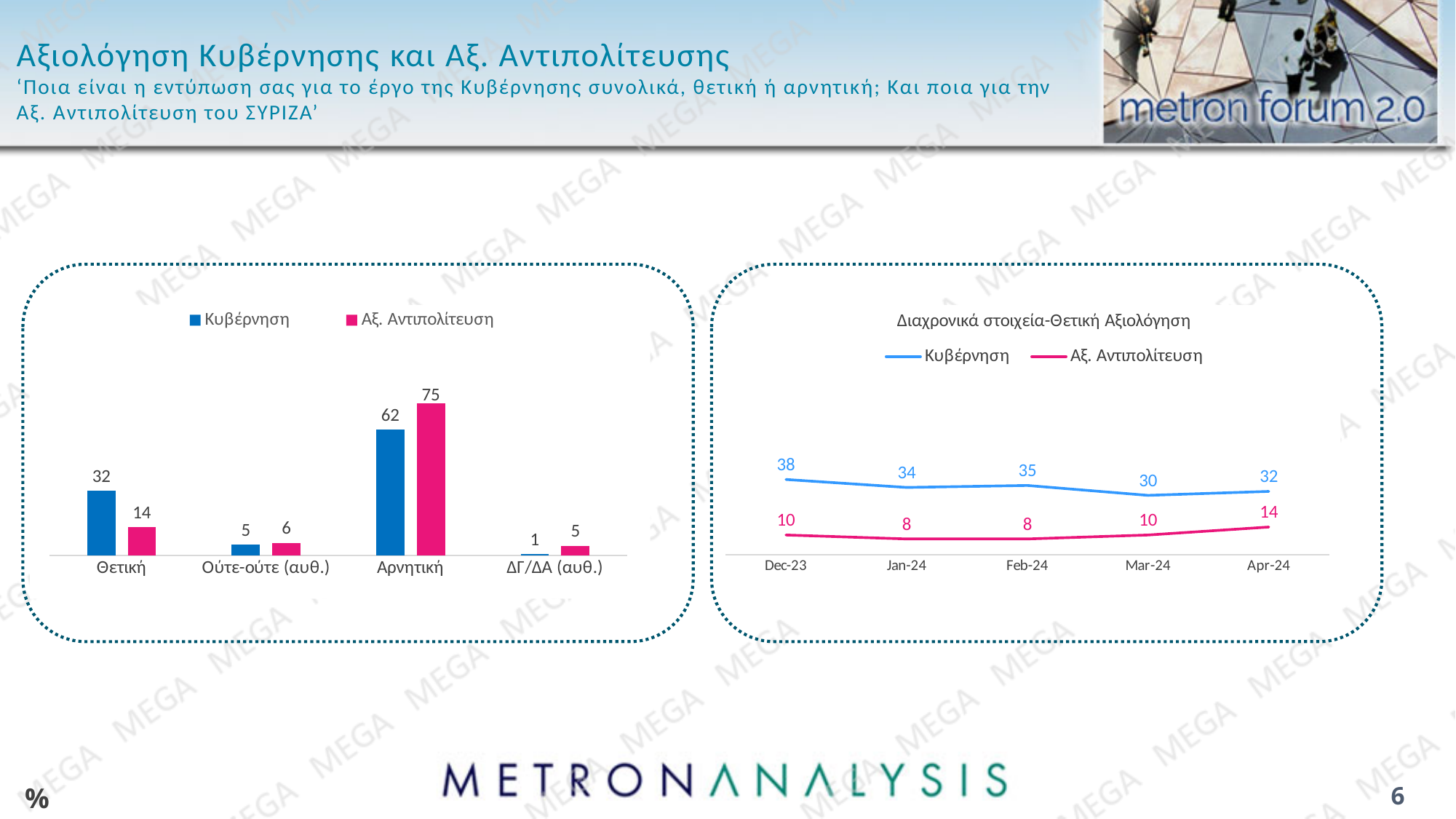
What type of chart is the chart on the right, titled 'Διαχρονικά στοιχεία-Θετική Αξιολόγηση'? line chart In the left bar chart, which category has the lowest value for Κυβέρνηση? ΔΓ/ΔΑ (αυθ.) In the left bar chart, what is the difference between Αξ. Αντιπολίτευση and Κυβέρνηση in the Αρνητική category? 13 In the right line chart, what is the value for Κυβέρνηση in Dec-23? 38 How many categories are shown on the x axis of the left bar chart? 4 In the left bar chart, what is the value for Κυβέρνηση in the Θετική category? 32 In the right line chart, what is the value for Αξ. Αντιπολίτευση in Apr-24? 14 In the left bar chart, which category has the highest value for Κυβέρνηση? Αρνητική In the left bar chart, what is the value for Αξ. Αντιπολίτευση in the Αρνητική category? 75 In the left bar chart, which series has the larger value in the Θετική category? Κυβέρνηση How many series does the legend of the right line chart list? 2 In the right line chart, in which month is the Κυβέρνηση value lowest? Mar-24